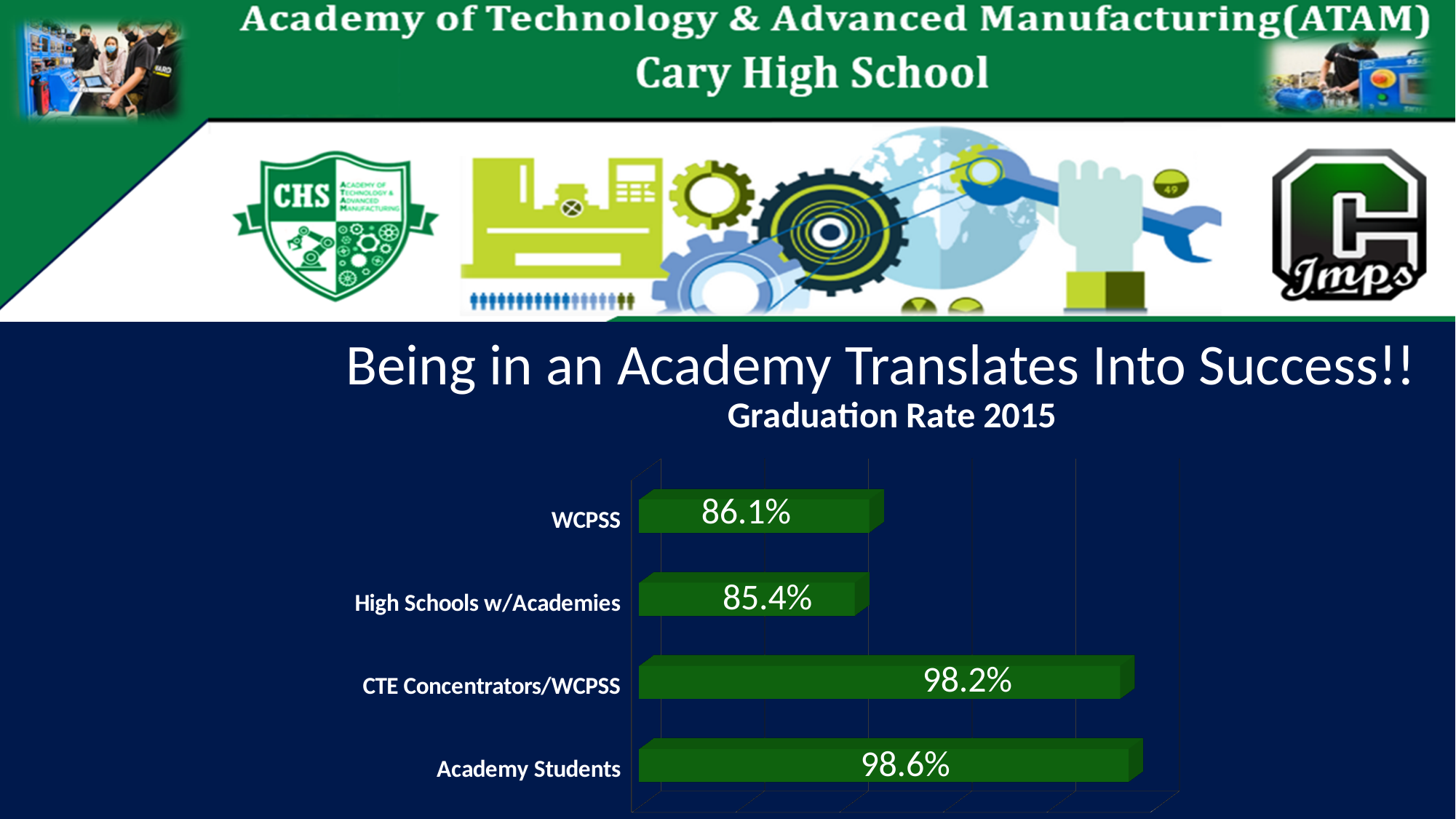
What is the graduation rate shown for CTE Concentrators/WCPSS? 98.2% What type of chart is used to show the graduation rates? Bar chart Which category has the highest graduation rate in the chart? Academy Students What is the graduation rate shown for WCPSS? 86.1% What is the graduation rate shown for High Schools w/Academies? 85.4% What is the title of the chart on the slide? Graduation Rate 2015 What is the difference in graduation rate between Academy Students and WCPSS? 12.5 percentage points Which category has the lowest graduation rate in the chart? High Schools w/Academies Which has a higher graduation rate, WCPSS or High Schools w/Academies? WCPSS What is the graduation rate shown for Academy Students? 98.6% How many categories are shown in the graduation rate chart? 4 What is the difference in graduation rate between CTE Concentrators/WCPSS and High Schools w/Academies? 12.8 percentage points